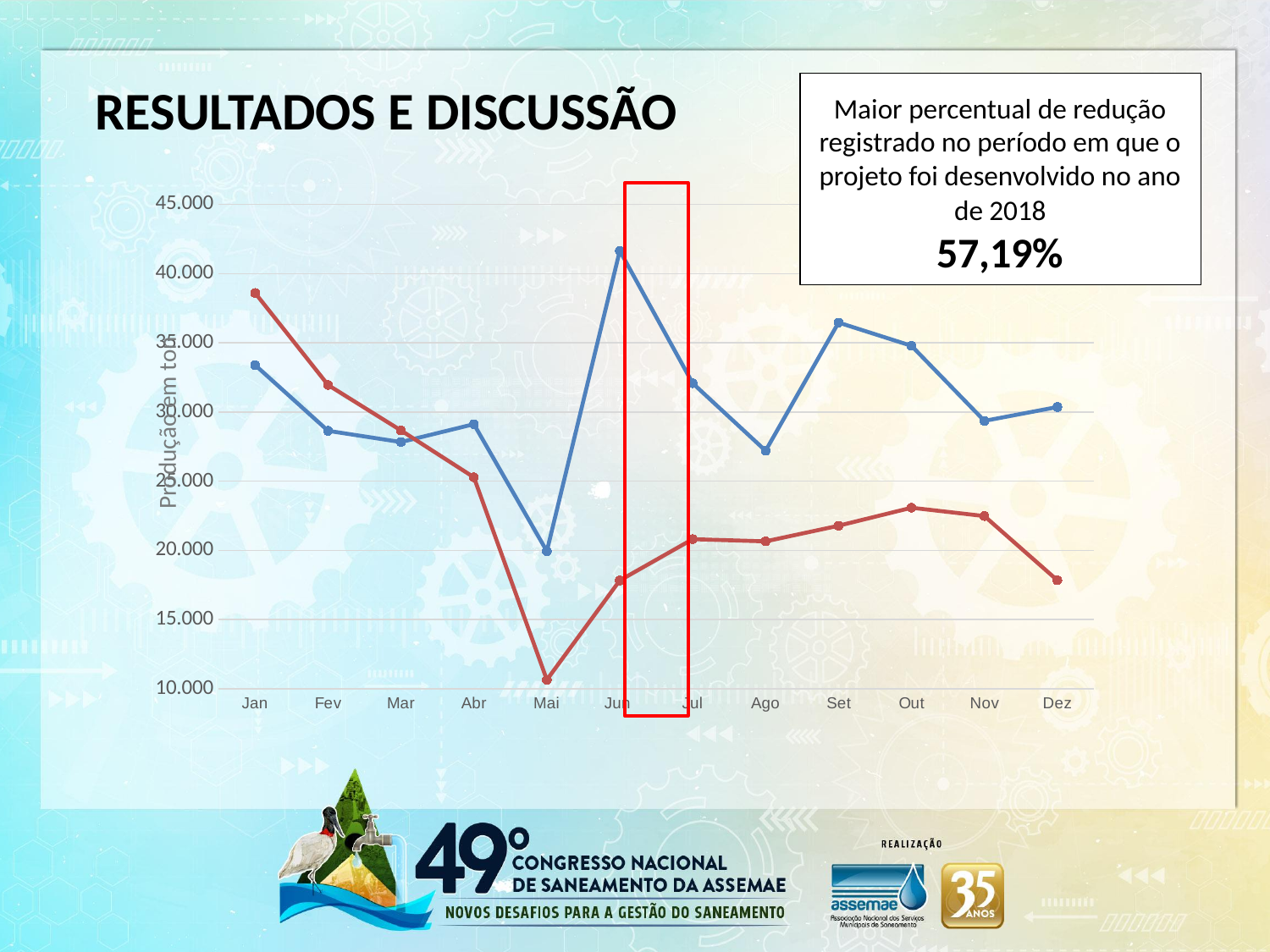
How many months are shown on the x axis of the chart? 12 In which month does the blue line reach its highest value? Jun In which month does the blue line reach its lowest value? Mai What kind of chart is shown on the slide? line chart How many lines are plotted on the chart? 2 Is the value of the red line in Dez greater or less than 20.000? less In which month does the red line reach its lowest value? Mai In Jan, which line has the higher value, the red line or the blue line? red line In which month does the red line reach its highest value? Jan Is the value of the red line in Mai greater or less than 15.000? less Does the red line rise or fall from Jan to Mai? fall Is the value of the blue line in Jun greater or less than 40.000? greater